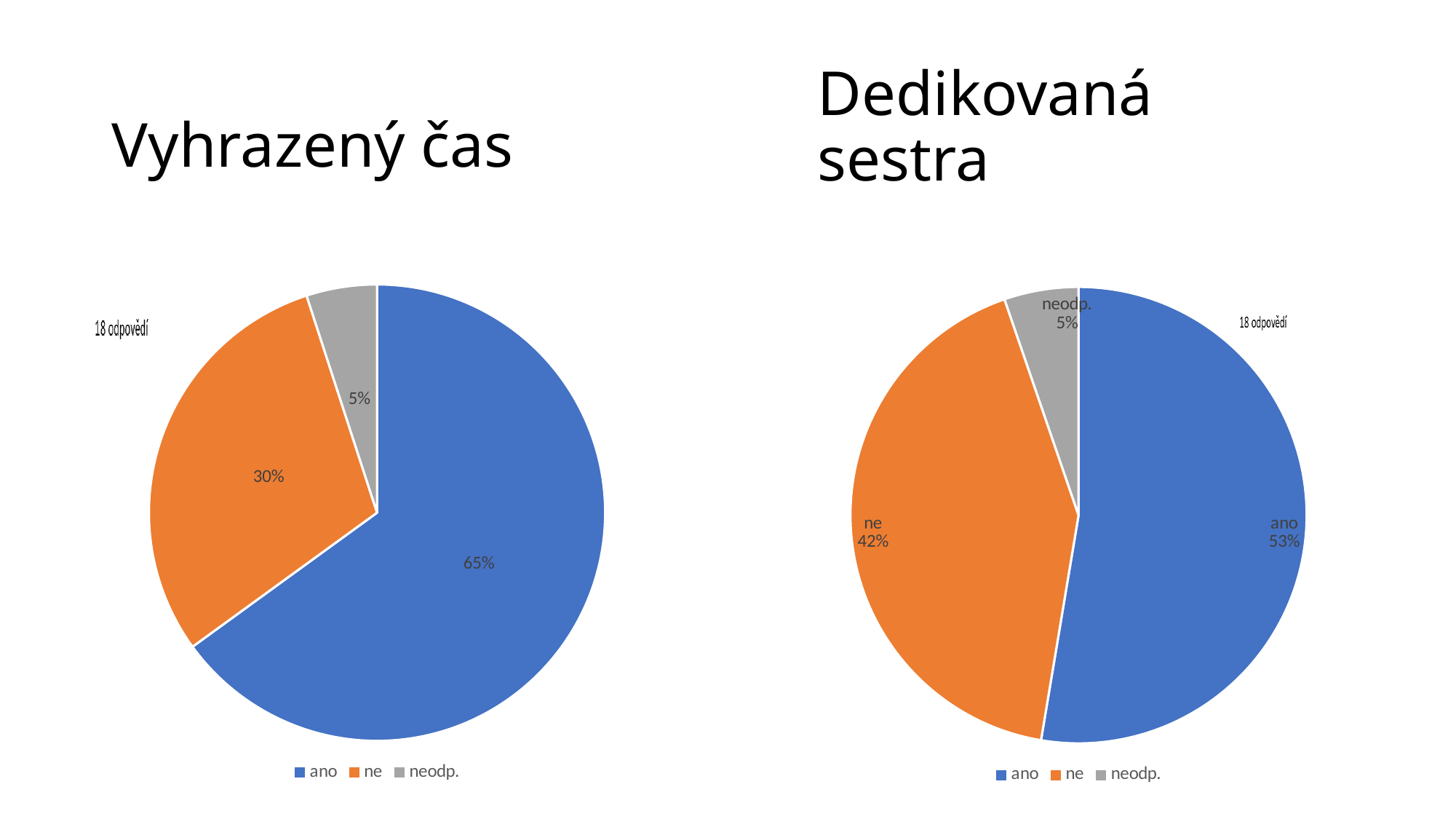
In the 'Dedikovaná sestra' chart, what is the difference between the 'ano' and 'ne' shares? 11% In the 'Dedikovaná sestra' chart, which category has the smallest slice? neodp. In the 'Vyhrazený čas' chart, which category has the largest slice? ano How many categories does the legend of the 'Vyhrazený čas' chart list? 3 In the 'Dedikovaná sestra' chart, what share does 'ano' have? 53% What kind of chart is the 'Dedikovaná sestra' chart? pie chart In the 'Vyhrazený čas' chart, what share does 'neodp.' have? 5% In the 'Dedikovaná sestra' chart, what share does 'neodp.' have? 5% In the 'Vyhrazený čas' chart, which is larger, 'ne' or 'neodp.'? ne